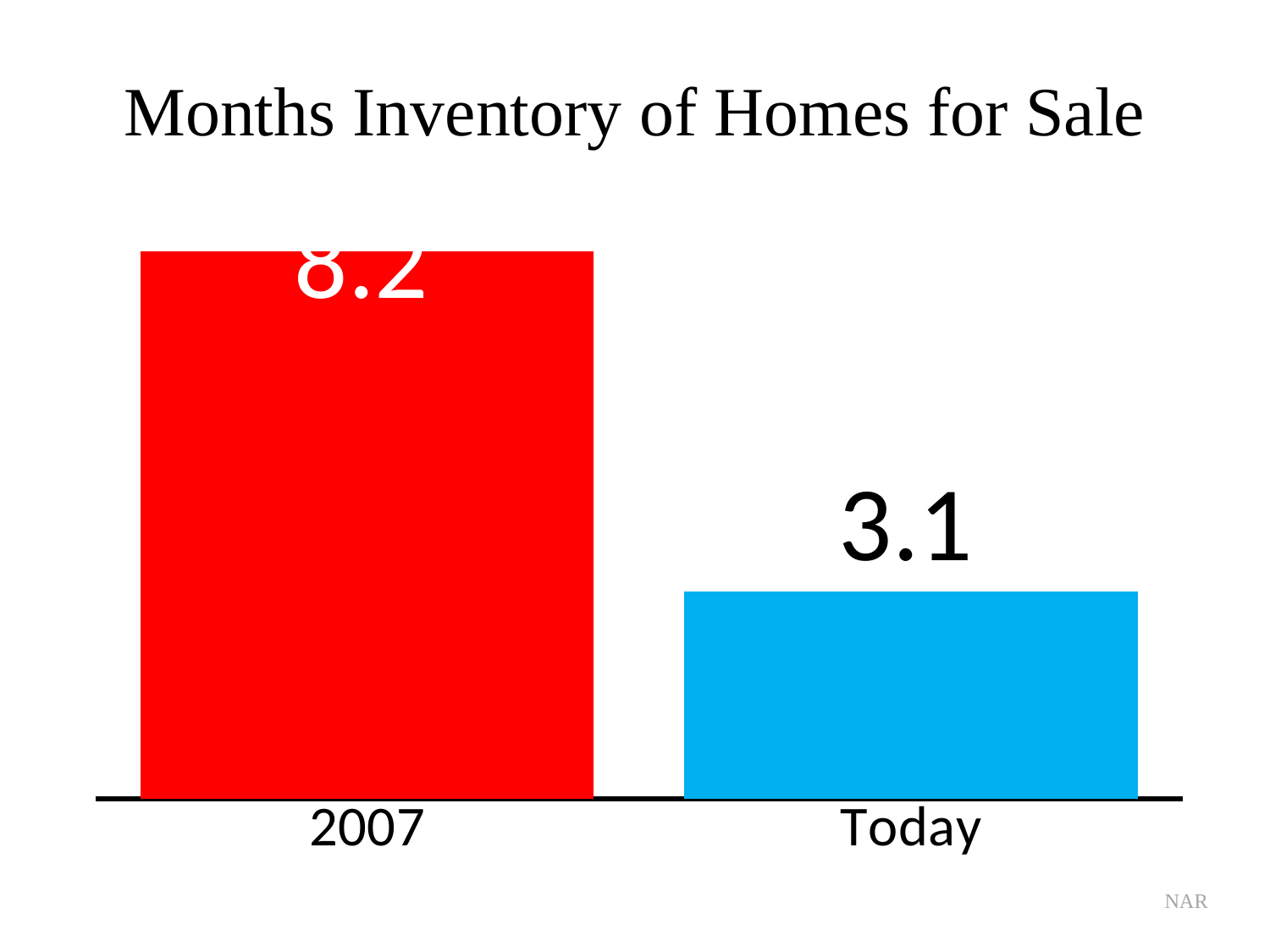
What is the months inventory value for 2007? 8.2 Do the values rise or fall from 2007 to Today? Fall What kind of chart is shown on the slide? Bar chart How many categories are shown in the chart? 2 What is the months inventory value for Today? 3.1 Which category has the lowest months inventory? Today Which category has the highest months inventory? 2007 Which is larger, the value for 2007 or the value for Today? 2007 What is the difference between the 2007 value and the Today value? 5.1 What colour is the bar for Today? Blue What is the title of the chart? Months Inventory of Homes for Sale